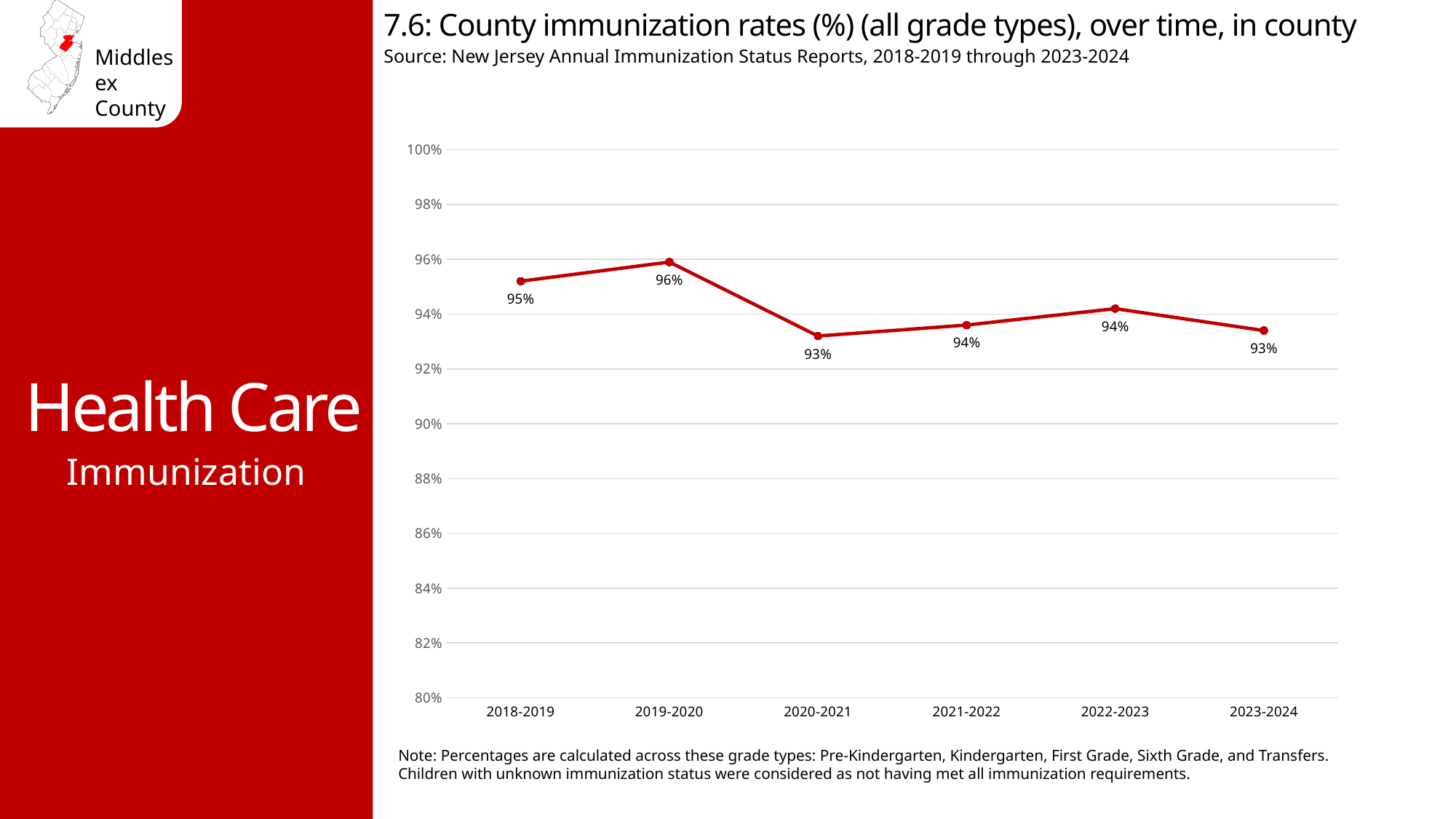
Did the immunization rate rise or fall from 2019-2020 to 2020-2021? Fall Is the value for 2018-2019 greater or less than 94%? greater Which school year had the highest county immunization rate? 2019-2020 What was the county immunization rate in 2021-2022? 94% What was the county immunization rate in 2018-2019? 95% What is the difference between the immunization rate in 2019-2020 and in 2020-2021? 3 percentage points Which year had a higher immunization rate, 2019-2020 or 2023-2024? 2019-2020 How many school years are plotted on the chart? 6 What kind of chart is shown on the slide? Line chart What was the county immunization rate in 2019-2020? 96% Is the value for 2020-2021 greater or less than 94%? less What was the county immunization rate in 2023-2024? 93%